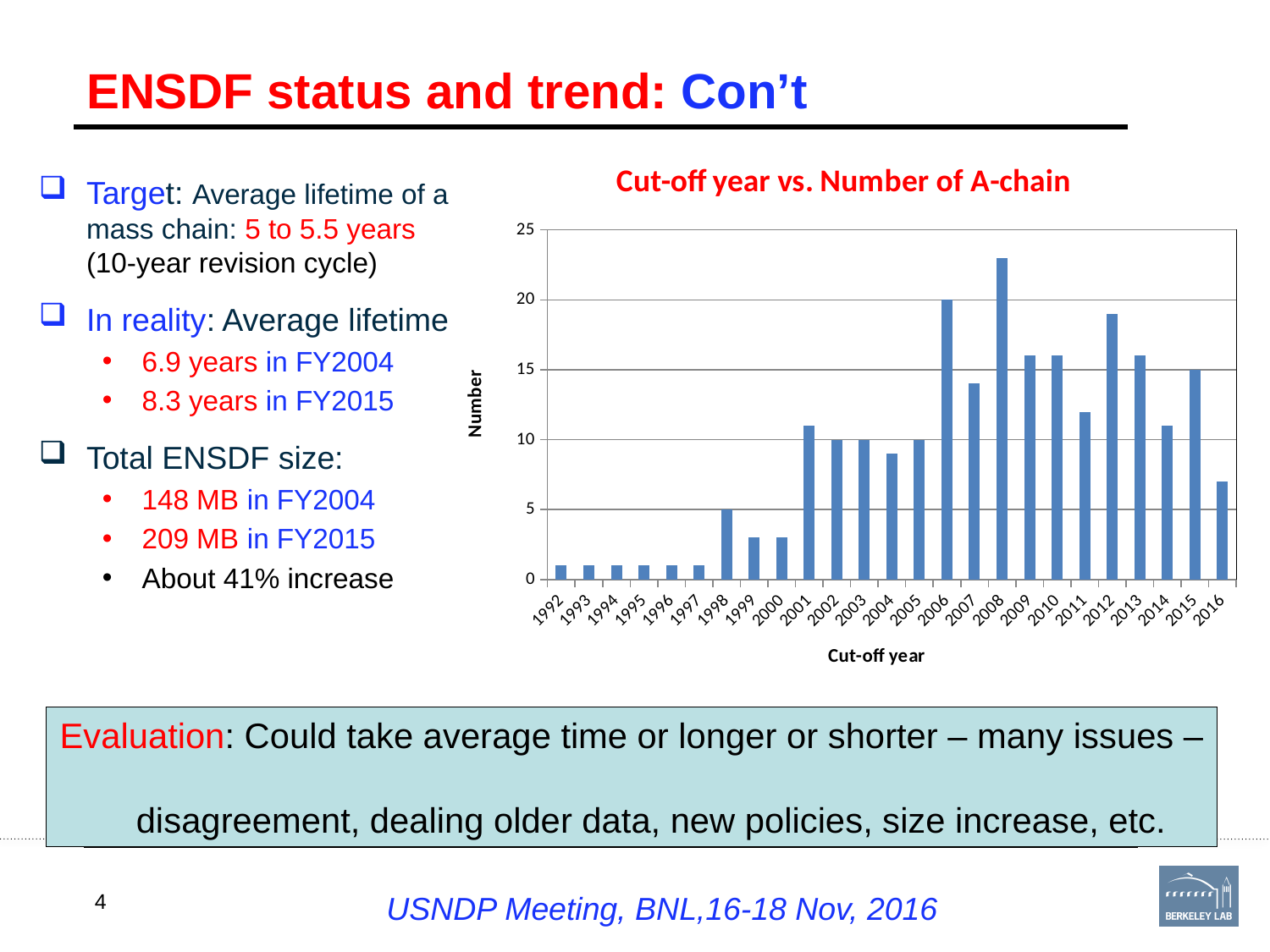
Which cut-off year has the larger number of A-chains, 2006 or 2007? 2006 Is the value for cut-off year 1999 greater or less than 5? less Is the value for cut-off year 2008 greater or less than 20? greater How many cut-off years are shown on the x axis of the chart? 25 Is the value for cut-off year 2016 greater or less than 5? greater Which cut-off year has the highest number of A-chains? 2008 What is the label of the vertical axis of the chart? Number What is the number of A-chains for cut-off year 1998? 5 What is the title of the chart? Cut-off year vs. Number of A-chain Do the values generally rise or fall from 1992 to 2001? rise What is the number of A-chains for cut-off year 2006? 20 What type of chart is shown on the slide? bar chart